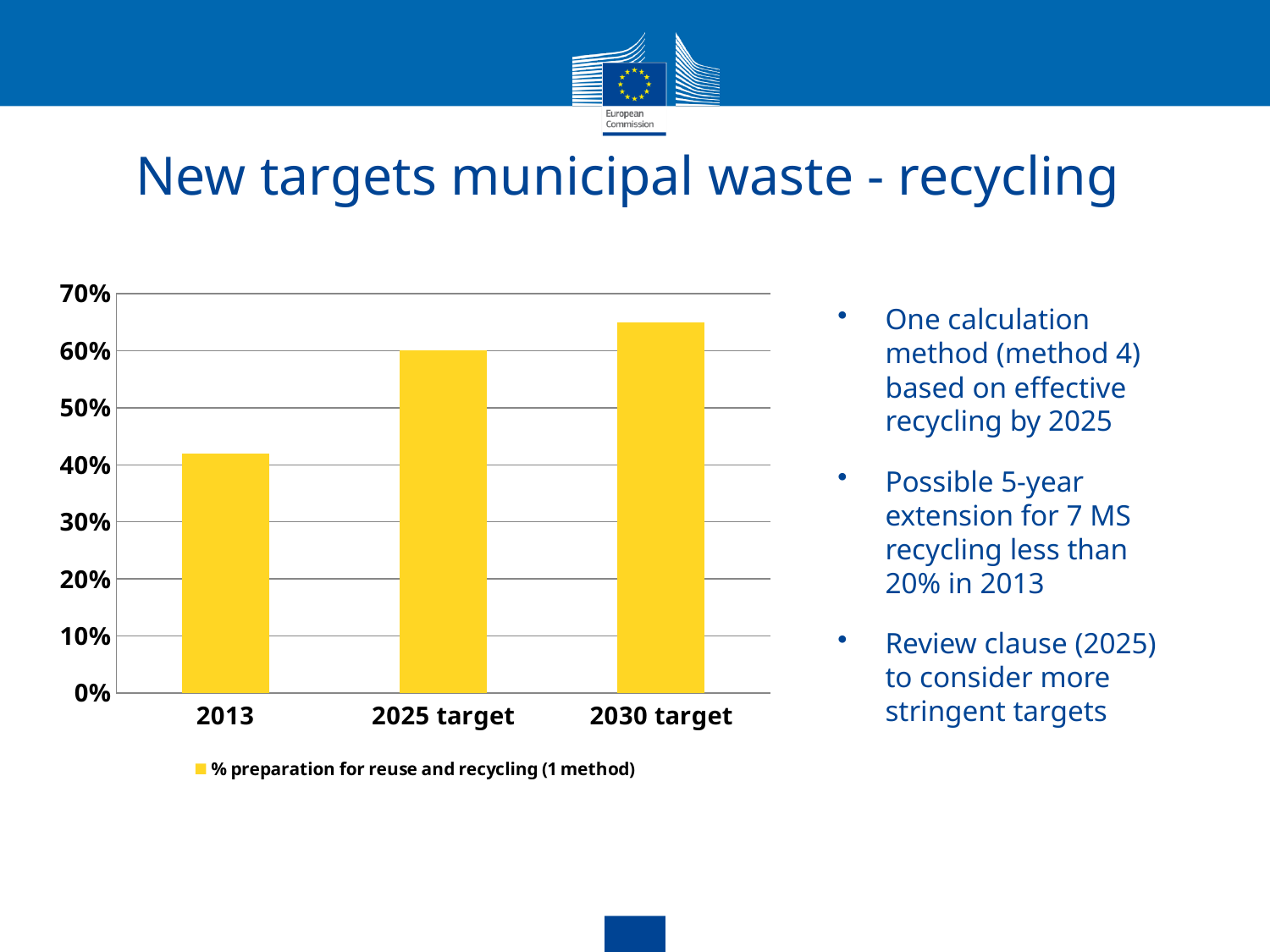
Which category has the highest value? 2030 target Which is larger, the value for 2013 or the value for the 2025 target? 2025 target What kind of chart is shown on the slide? bar chart How many series does the chart legend list? 1 Do the values rise or fall from 2013 to the 2030 target? rise Which category has the lowest value? 2013 How many categories are shown on the x axis of the chart? 3 Is the value for the 2030 target greater or less than 60%? greater What is the series name shown in the chart legend? % preparation for reuse and recycling (1 method) What is the value for the 2025 target? 60% Is the value for 2013 greater or less than 50%? less Is the value for 2013 greater or less than 40%? greater